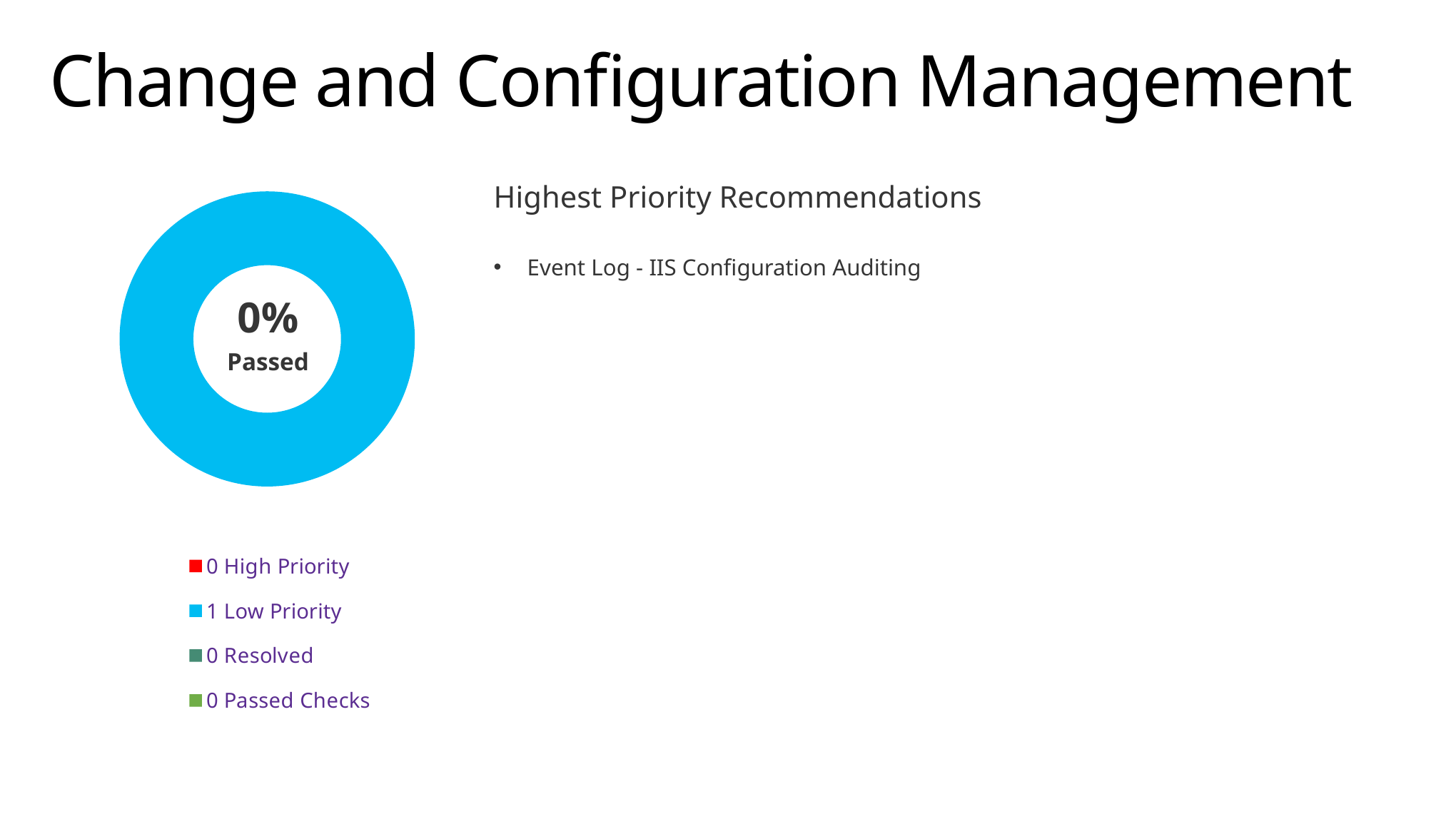
What colour represents Low Priority in the legend? blue How many Resolved items does the legend show? 0 Which category fills the entire doughnut chart? Low Priority How many High Priority items does the legend show? 0 What percentage is shown in the centre of the doughnut chart? 0% What kind of chart is shown on the slide? doughnut chart How many entries does the chart legend list? 4 What word appears below the percentage in the centre of the doughnut chart? Passed How many Passed Checks does the legend show? 0 Which legend category has the highest count? Low Priority What is the difference between the Low Priority count and the High Priority count? 1 How many Low Priority items does the legend show? 1